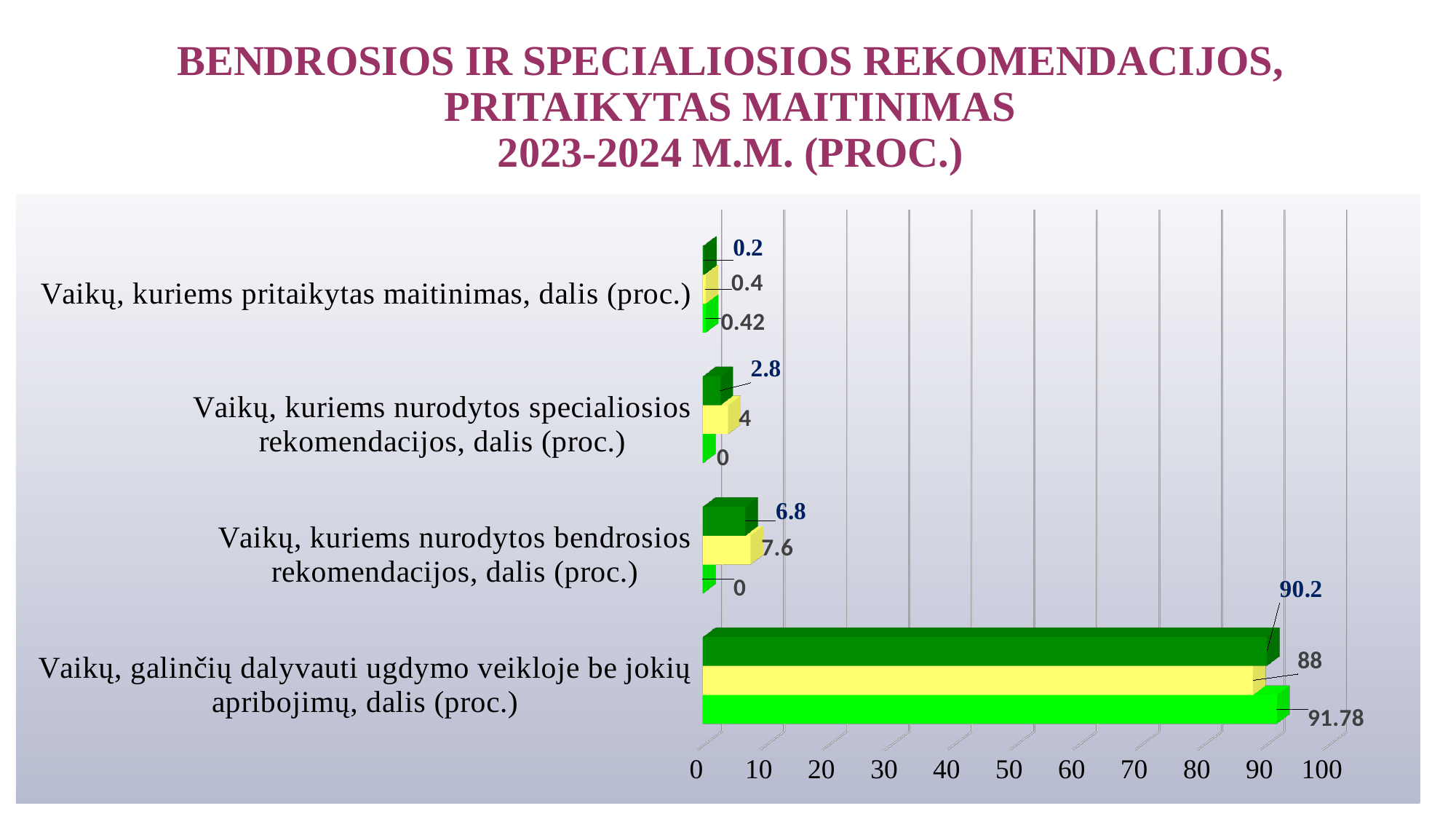
What is the difference between the light green and yellow bar values for "Vaikų, galinčių dalyvauti ugdymo veikloje be jokių apribojimų, dalis (proc.)"? 3.78 What is the yellow bar value for "Vaikų, kuriems nurodytos bendrosios rekomendacijos, dalis (proc.)"? 7.6 What kind of chart is shown on the slide? bar chart How many categories are shown on the chart? 4 What is the yellow bar value for "Vaikų, kuriems pritaikytas maitinimas, dalis (proc.)"? 0.4 For "Vaikų, kuriems nurodytos bendrosios rekomendacijos, dalis (proc.)", which is larger: the dark green bar or the yellow bar? the yellow bar Which category has the lowest dark green bar value? Vaikų, kuriems pritaikytas maitinimas, dalis (proc.) What is the dark green bar value for "Vaikų, kuriems nurodytos specialiosios rekomendacijos, dalis (proc.)"? 2.8 What is the light green bar value for "Vaikų, galinčių dalyvauti ugdymo veikloje be jokių apribojimų, dalis (proc.)"? 91.78 What is the dark green bar value for "Vaikų, galinčių dalyvauti ugdymo veikloje be jokių apribojimų, dalis (proc.)"? 90.2 Is the yellow bar value for "Vaikų, galinčių dalyvauti ugdymo veikloje be jokių apribojimų, dalis (proc.)" greater or less than 80? greater Which category has the highest dark green bar value? Vaikų, galinčių dalyvauti ugdymo veikloje be jokių apribojimų, dalis (proc.)